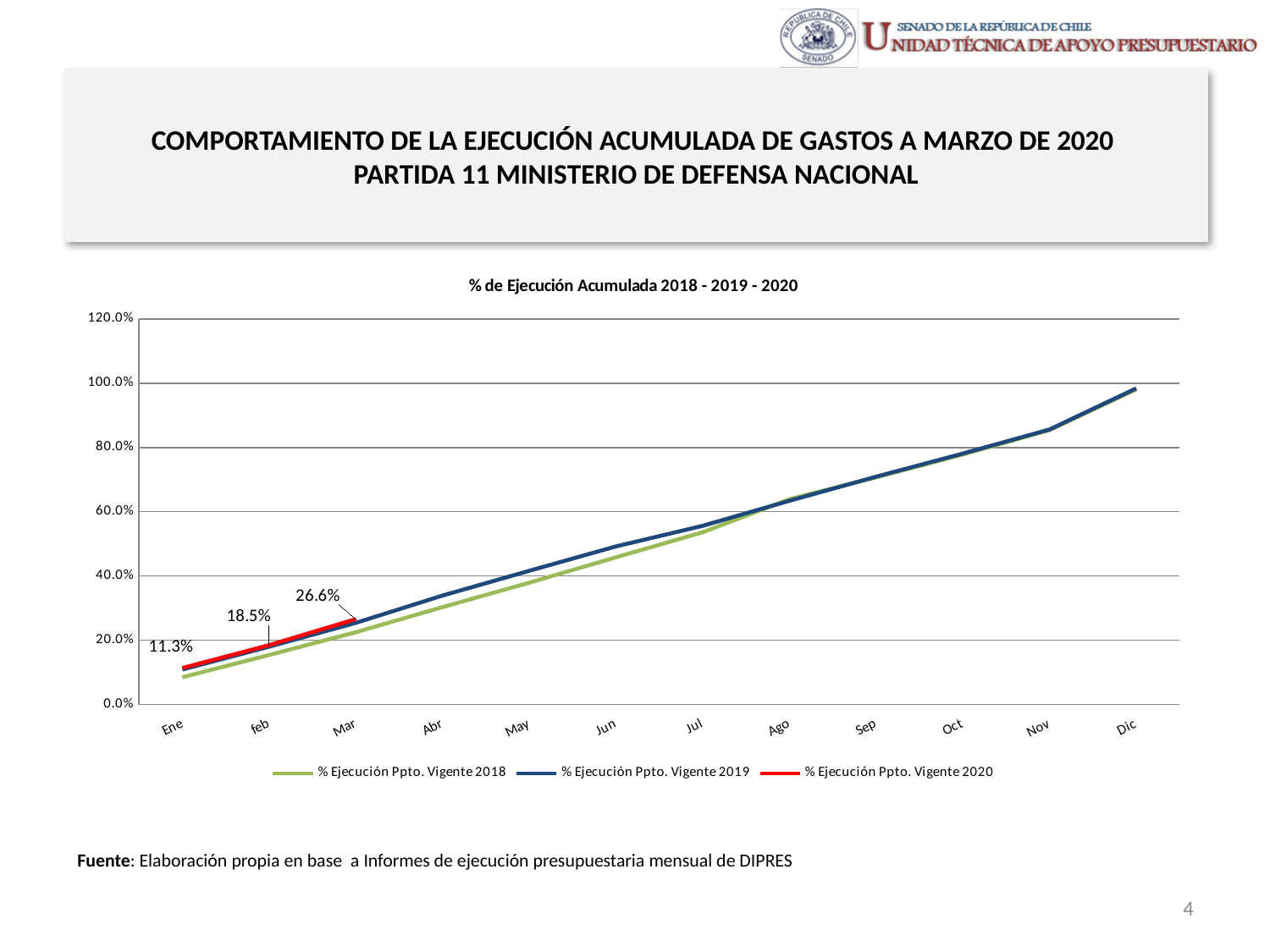
What kind of chart is shown on the slide? Line chart What is the title of the chart? % de Ejecución Acumulada 2018 - 2019 - 2020 By how many percentage points does the 2020 series increase from Ene to Mar? 15.3 percentage points What is the difference between the 2020 values for Feb and Ene? 7.2 percentage points What is the value of % Ejecución Ppto. Vigente 2020 in Feb? 18.5% What is the value of % Ejecución Ppto. Vigente 2020 in Mar? 26.6% How many months are shown on the x axis? 12 How many series does the legend list? 3 Does the % Ejecución Ppto. Vigente 2019 series rise or fall from Ene to Dic? Rises Among the labelled 2020 values, which month is the highest? Mar Is the value for % Ejecución Ppto. Vigente 2019 in Dic greater or less than 80%? greater What is the value of % Ejecución Ppto. Vigente 2020 in Ene? 11.3%